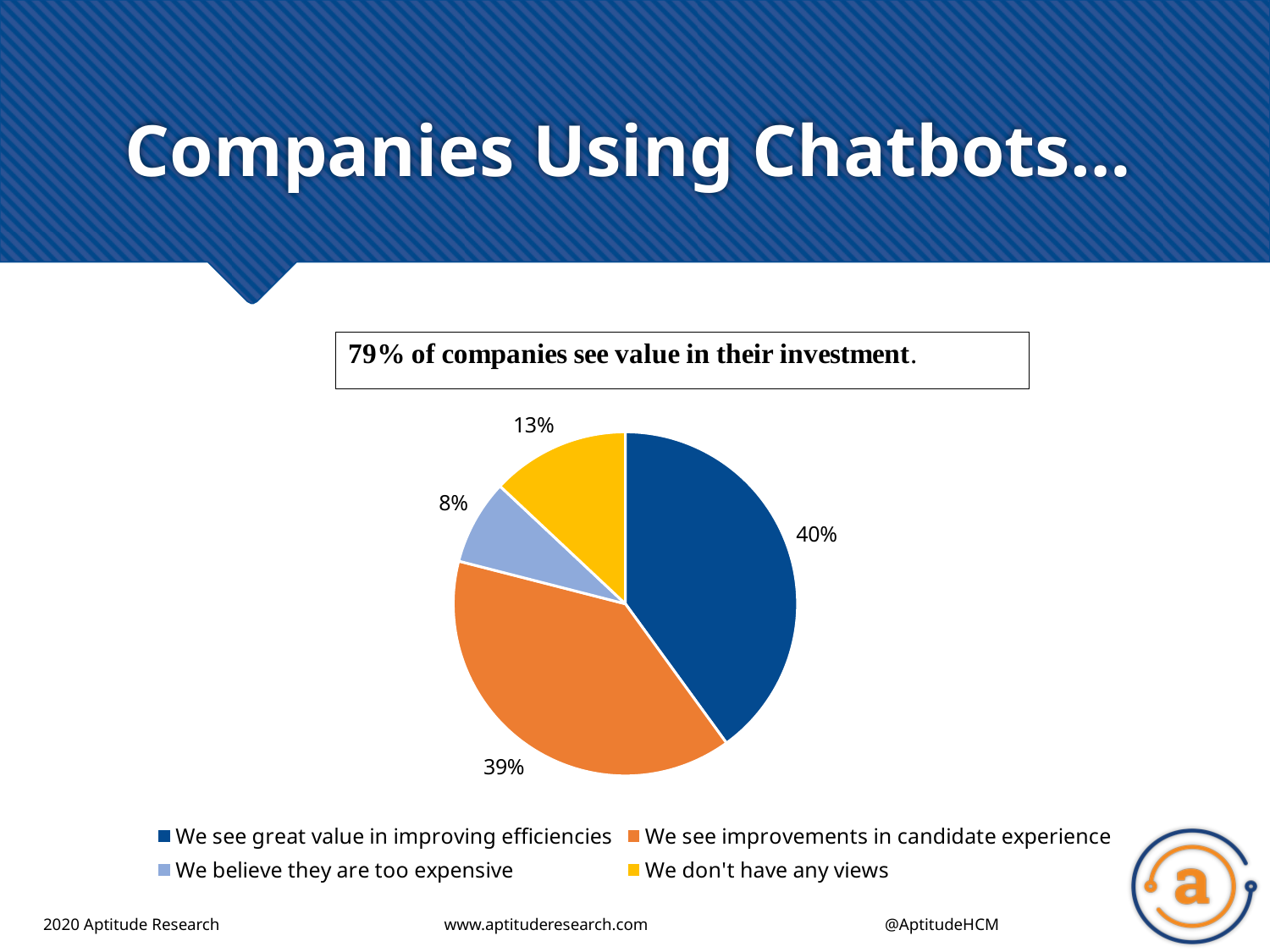
Which response has the smallest share of the pie? We believe they are too expensive What percentage of companies say they see improvements in candidate experience? 39% Which is larger: the share for 'We don't have any views' or the share for 'We believe they are too expensive'? We don't have any views What percentage of companies say they see great value in improving efficiencies? 40% What percentage of companies believe chatbots are too expensive? 8% What is the difference between the share for 'We don't have any views' and the share for 'We believe they are too expensive'? 5% How many entries does the legend list? 4 What percentage of companies don't have any views? 13% What colour is the slice for 'We don't have any views'? yellow Which response has the largest share of the pie? We see great value in improving efficiencies What kind of chart is shown on the slide? pie chart How many slices does the pie chart have? 4